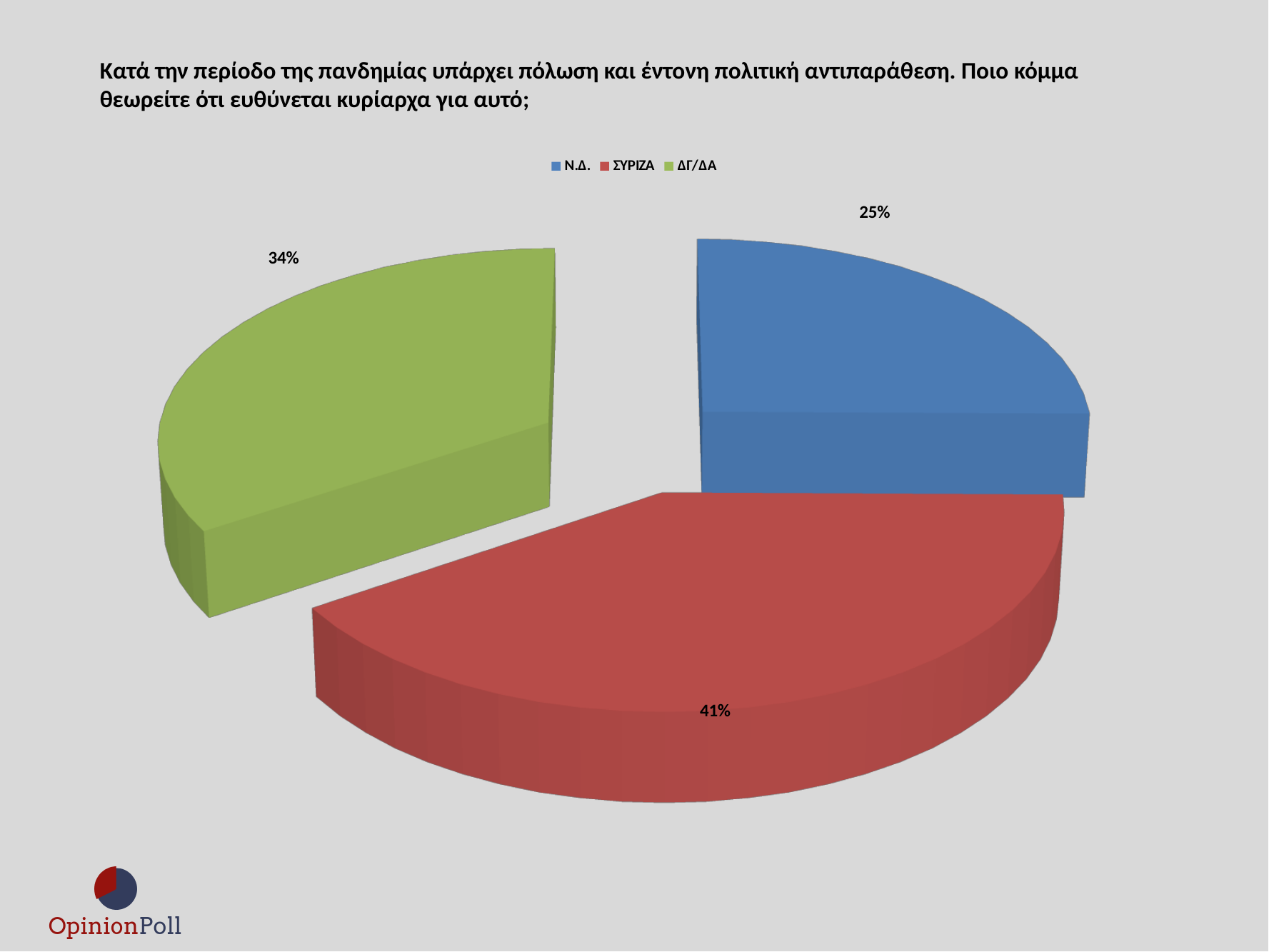
Which category has the largest slice of the pie? ΣΥΡΙΖΑ What percentage of the pie is labelled for ΔΓ/ΔΑ? 34% Which slice is larger, ΣΥΡΙΖΑ or ΔΓ/ΔΑ? ΣΥΡΙΖΑ What is the difference in percentage points between the ΔΓ/ΔΑ slice and the Ν.Δ. slice? 9 Which category has the smallest slice of the pie? Ν.Δ. How many slices does the pie chart have? 3 What percentage of the pie is labelled for ΣΥΡΙΖΑ? 41% Which slice is larger, ΔΓ/ΔΑ or Ν.Δ.? ΔΓ/ΔΑ What percentage of the pie is labelled for Ν.Δ.? 25% Which colour represents ΣΥΡΙΖΑ in the legend? Red What kind of chart is shown on the slide? Pie chart What is the difference in percentage points between the ΣΥΡΙΖΑ slice and the Ν.Δ. slice? 16